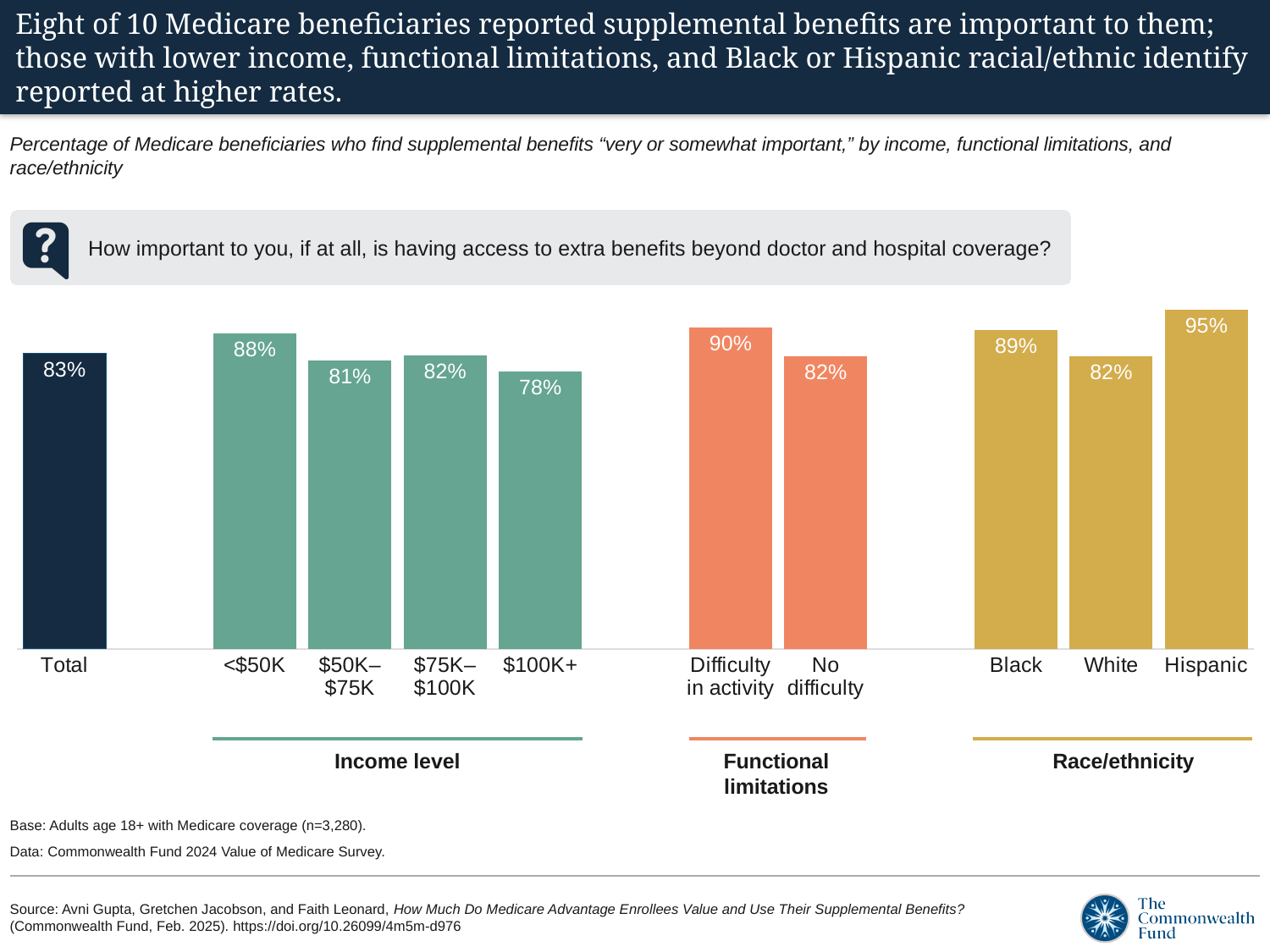
What is the difference between the values for Hispanic and White beneficiaries? 13 percentage points What kind of chart is shown on the slide? Bar chart What is the value for Hispanic beneficiaries? 95% What is the value for beneficiaries with difficulty in activity? 90% Which is larger, the value for <$50K or the value for $100K+? <$50K What is the value for beneficiaries with income under $50K? 88% What percentage of all Medicare beneficiaries (Total) find supplemental benefits very or somewhat important? 83% How many bars are shown in the Income level group? 4 What colour are the bars in the Race/ethnicity group? Gold/yellow What is the difference between the values for those with difficulty in activity and those with no difficulty? 8 percentage points Which income level has the lowest value? $100K+ Which category on the chart has the highest value? Hispanic